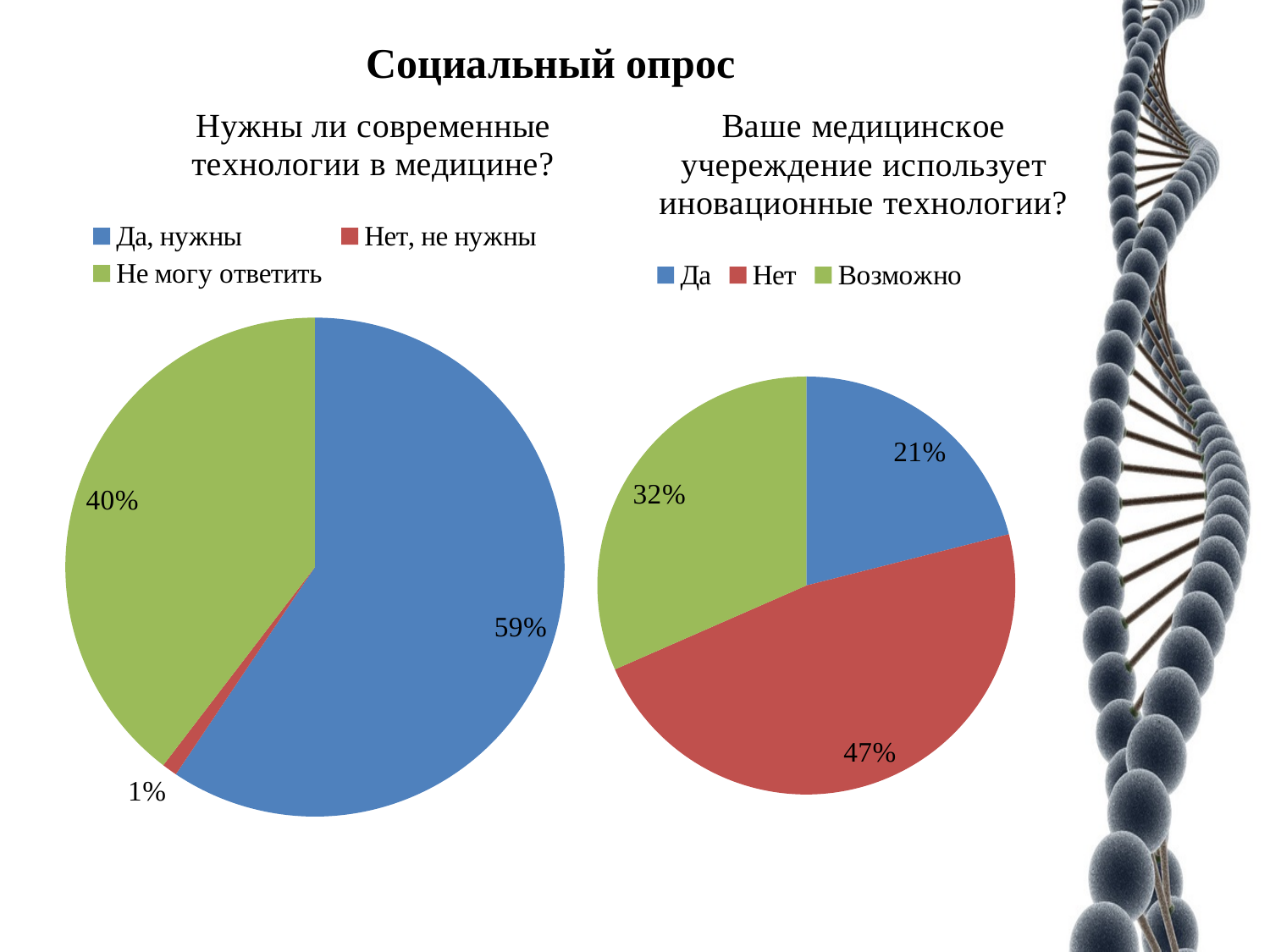
What type of chart is used for the left chart 'Нужны ли современные технологии в медицине?'? Pie chart In the right chart 'Ваше медицинское учереждение использует иновационные технологии?', what share of respondents answered 'Нет'? 47% In the left chart 'Нужны ли современные технологии в медицине?', what share of respondents answered 'Не могу ответить'? 40% How many categories does the legend of the right chart 'Ваше медицинское учереждение использует иновационные технологии?' list? 3 In the right chart 'Ваше медицинское учереждение использует иновационные технологии?', what share of respondents answered 'Да'? 21% In the right chart 'Ваше медицинское учереждение использует иновационные технологии?', what share of respondents answered 'Возможно'? 32% In the left chart 'Нужны ли современные технологии в медицине?', what is the difference between the shares for 'Да, нужны' and 'Не могу ответить'? 19% In the left chart 'Нужны ли современные технологии в медицине?', what share of respondents answered 'Нет, не нужны'? 1% In the right chart 'Ваше медицинское учереждение использует иновационные технологии?', which is larger: the share for 'Да' or the share for 'Возможно'? Возможно In the left chart 'Нужны ли современные технологии в медицине?', which answer has the smallest share? Нет, не нужны In the right chart 'Ваше медицинское учереждение использует иновационные технологии?', which answer has the largest share? Нет In the left chart 'Нужны ли современные технологии в медицине?', what share of respondents answered 'Да, нужны'? 59%